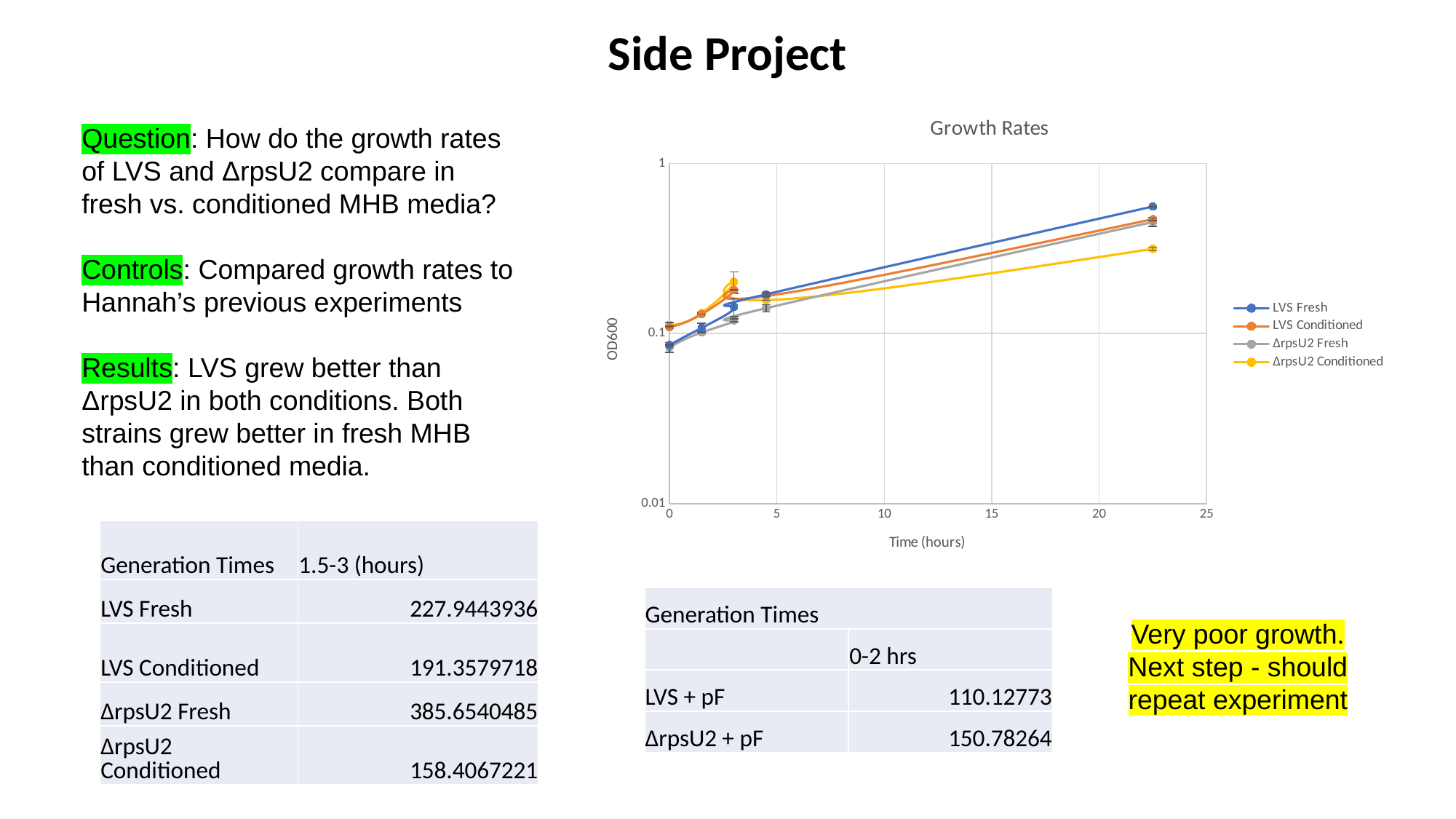
At the final time point in the "Growth Rates" chart, which series has the larger OD600: LVS Conditioned or ΔrpsU2 Conditioned? LVS Conditioned What is the label of the y axis on the "Growth Rates" chart? OD600 In the "Growth Rates" chart, is the OD600 of LVS Fresh at the final time point greater or less than 0.1? greater How many series does the legend of the "Growth Rates" chart list? 4 How many time points are plotted for each series in the "Growth Rates" chart? 5 What kind of chart is the "Growth Rates" chart? line chart In the "Growth Rates" chart, is the OD600 of ΔrpsU2 Conditioned at the final time point greater or less than 1? less Which series has the lowest OD600 at the final time point (around 22.5 hours) in the "Growth Rates" chart? ΔrpsU2 Conditioned Do the OD600 values for LVS Fresh rise or fall over time in the "Growth Rates" chart? rise What is the highest tick value shown on the x axis of the "Growth Rates" chart? 25 What is the title of the chart on the slide? Growth Rates Which series has the highest OD600 at the final time point (around 22.5 hours) in the "Growth Rates" chart? LVS Fresh